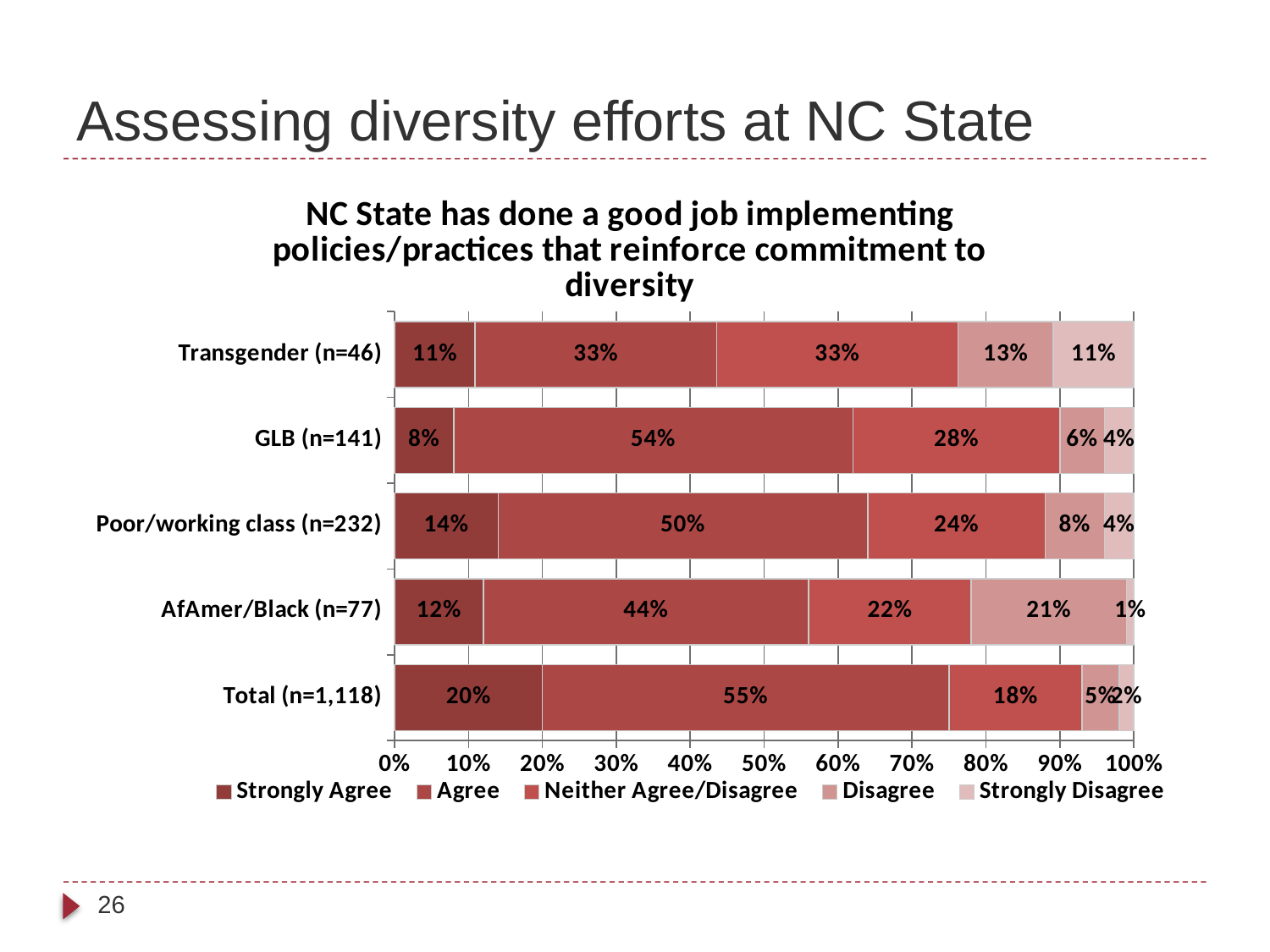
Which group has the highest Disagree percentage? AfAmer/Black (n=77) What is the Strongly Disagree value for AfAmer/Black (n=77)? 1% What percentage of GLB (n=141) respondents chose Agree? 54% Which group has a larger Neither Agree/Disagree share: Transgender (n=46) or Poor/working class (n=232)? Transgender (n=46) How many groups are shown on the chart? 5 What type of chart is shown on the slide? Stacked bar chart What is the Strongly Agree value for Total (n=1,118)? 20% Which group has the highest Strongly Agree percentage? Total (n=1,118) How many response categories does the legend list? 5 Which group has the lowest Strongly Agree percentage? GLB (n=141) What percentage of AfAmer/Black (n=77) respondents chose Disagree? 21% How many percentage points higher is the Strongly Disagree value for Transgender (n=46) than for GLB (n=141)? 7 percentage points